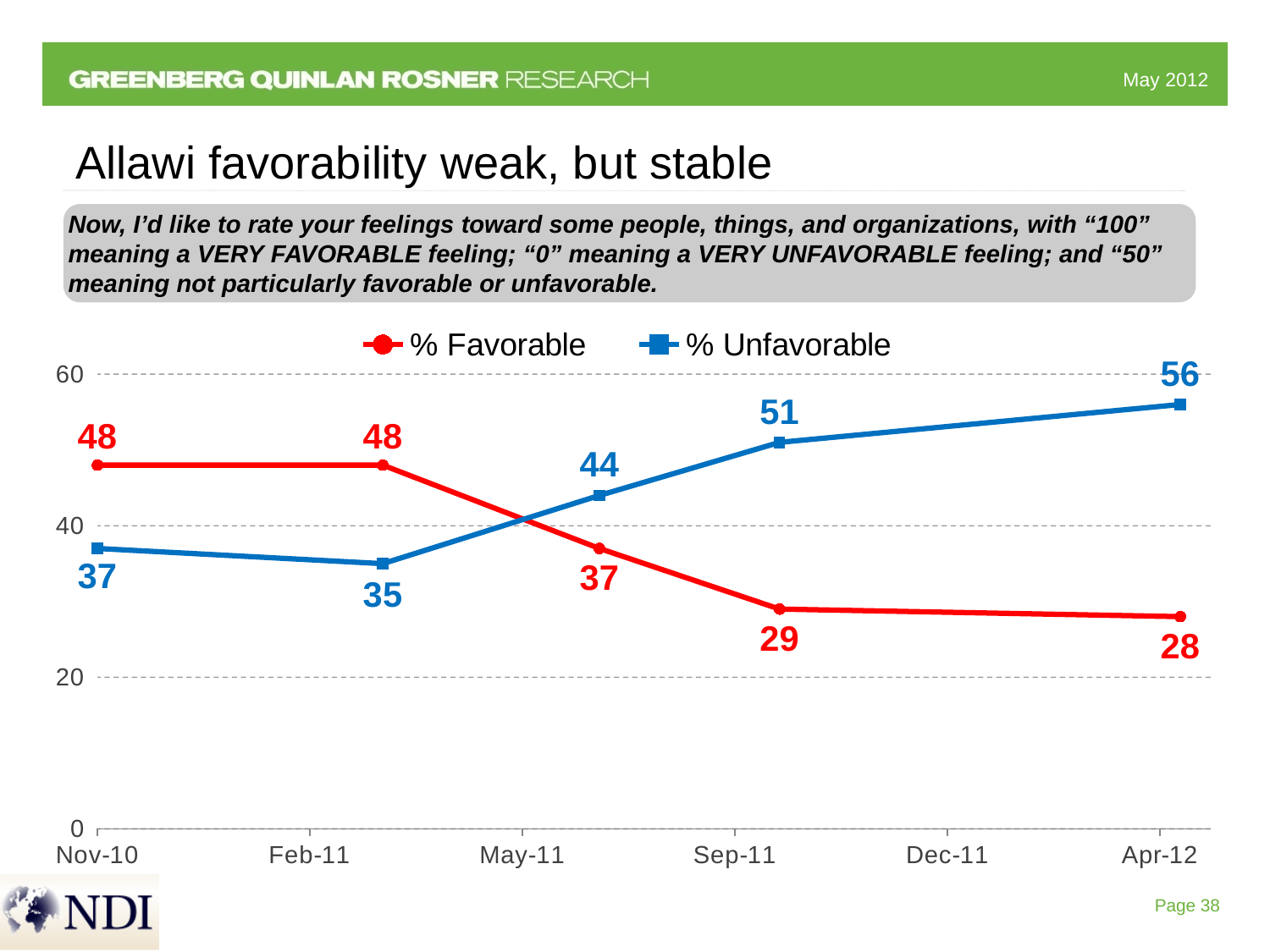
What is the % Unfavorable value at Apr-12? 56 What is the lowest value shown for the % Favorable series? 28 What is the highest value shown for the % Unfavorable series? 56 What is the % Favorable value at Nov-10? 48 How many data points are plotted for each series? 5 At Apr-12, how much higher is % Unfavorable than % Favorable? 28 At Nov-10, which series has the higher value, % Favorable or % Unfavorable? % Favorable How many series does the legend list? 2 Does the % Favorable series rise or fall from Nov-10 to Apr-12? Fall What is the % Unfavorable value at Nov-10? 37 What is the % Favorable value at Apr-12? 28 What kind of chart is shown on the slide? Line chart